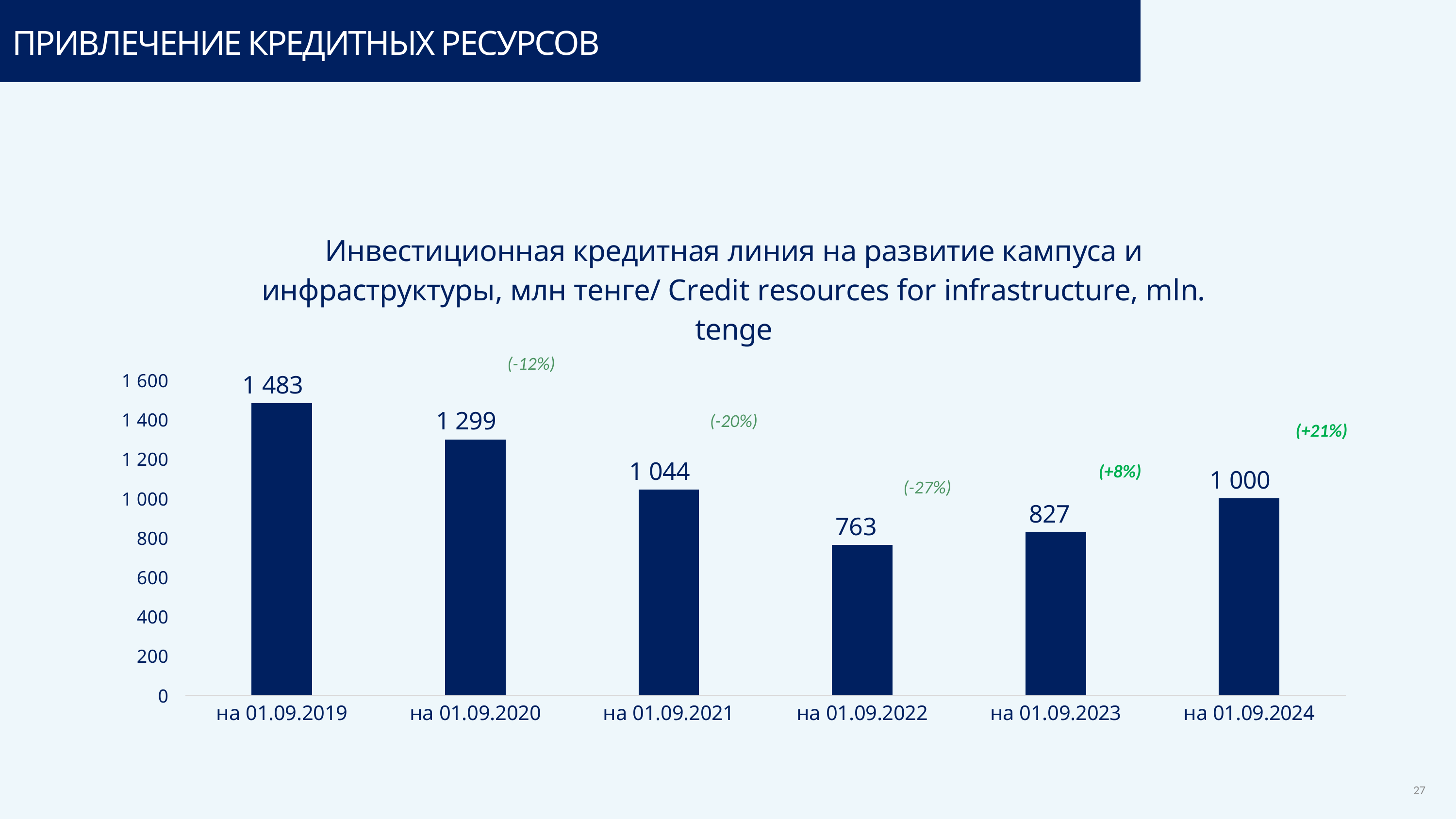
Which category has the lowest value? на 01.09.2022 How many categories are shown on the x axis? 6 What is the value for на 01.09.2019? 1 483 What is the value for на 01.09.2024? 1 000 Do the values rise or fall from на 01.09.2019 to на 01.09.2022? fall Which is larger, the value for на 01.09.2021 or the value for на 01.09.2024? на 01.09.2021 What percentage change is annotated above the bar for на 01.09.2024? (+21%) Which category has the highest value? на 01.09.2019 What is the value for на 01.09.2022? 763 What is the difference between the values for на 01.09.2019 and на 01.09.2020? 184 What is the difference between the values for на 01.09.2024 and на 01.09.2023? 173 What kind of chart is this? bar chart